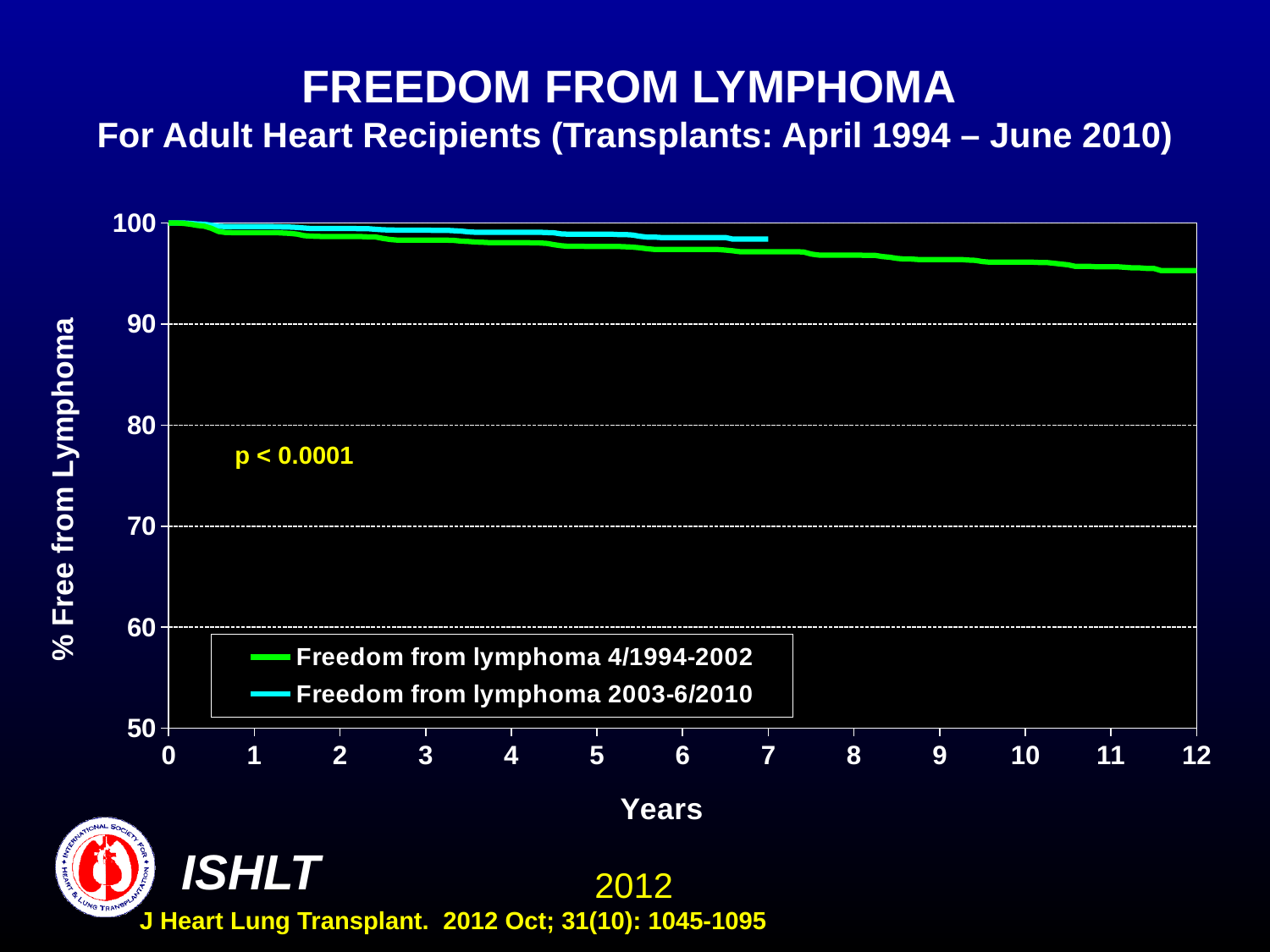
How many series does the legend list? 2 What is the lowest value shown on the y axis? 50 What is the label of the y axis? % Free from Lymphoma Is the value for Freedom from lymphoma 4/1994-2002 at 1 year greater or less than 90? greater Is the value for Freedom from lymphoma 2003-6/2010 at 7 years greater or less than 90? greater What kind of chart is shown on the slide? line chart At 5 years, which series has the higher value: Freedom from lymphoma 4/1994-2002 or Freedom from lymphoma 2003-6/2010? Freedom from lymphoma 2003-6/2010 Is the value for Freedom from lymphoma 4/1994-2002 at 12 years greater or less than 90? greater What is the highest value shown on the x axis? 12 Do the values for Freedom from lymphoma 4/1994-2002 rise or fall as years increase? fall What is the title of the chart? FREEDOM FROM LYMPHOMA What p-value is printed on the chart? p < 0.0001